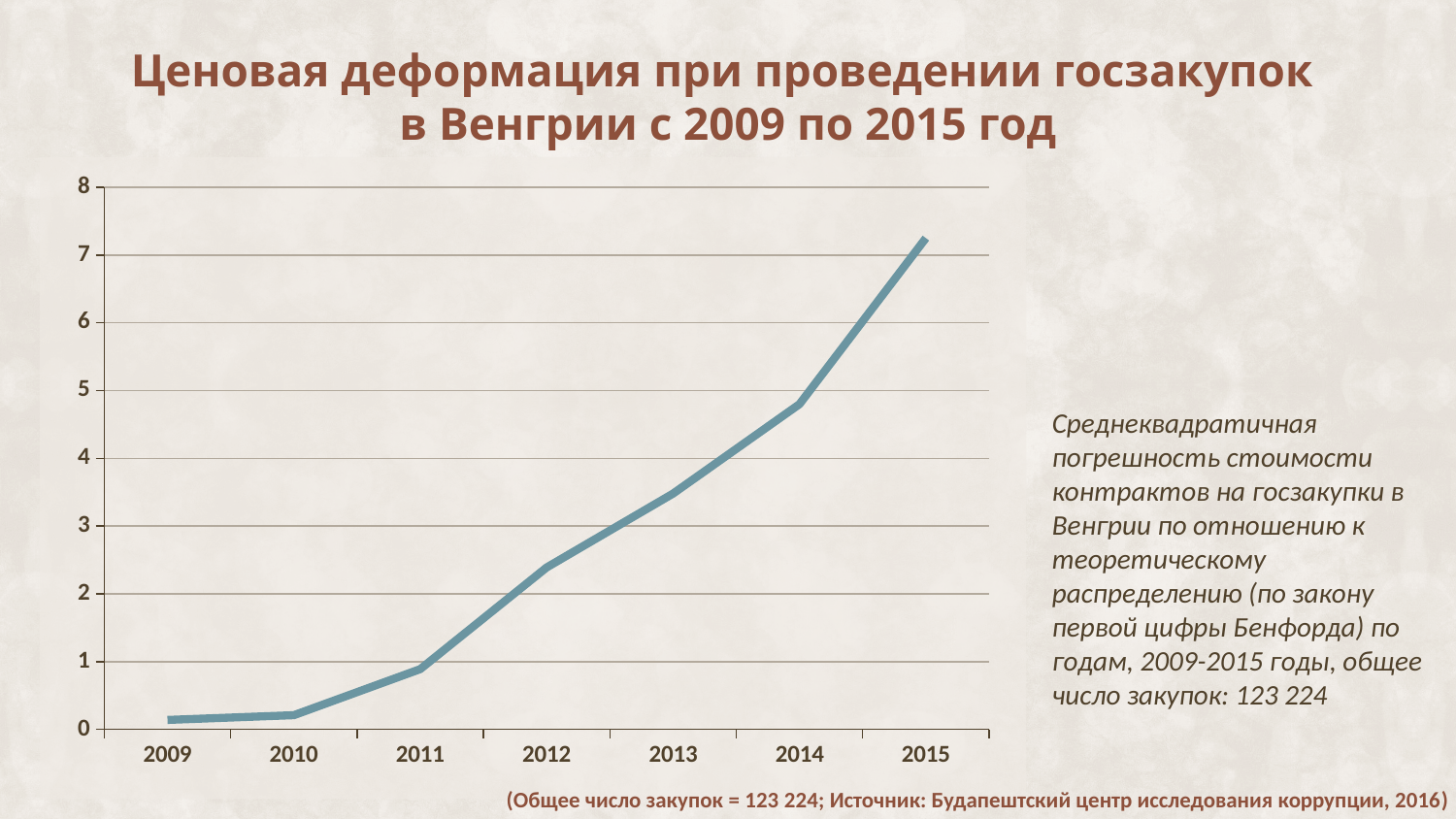
What is the highest tick value shown on the y axis of the chart? 8 Is the value for 2011 greater or less than 1? less What kind of chart is shown on the slide? line chart Which year has the highest value on the chart? 2015 Is the value for 2012 greater or less than 2? greater Is the value for 2014 greater or less than 5? less Which year has the larger value, 2012 or 2014? 2014 What is the first year shown on the x axis of the chart? 2009 How many years are plotted along the x axis of the chart? 7 Do the values on the chart rise or fall from 2009 to 2015? rise